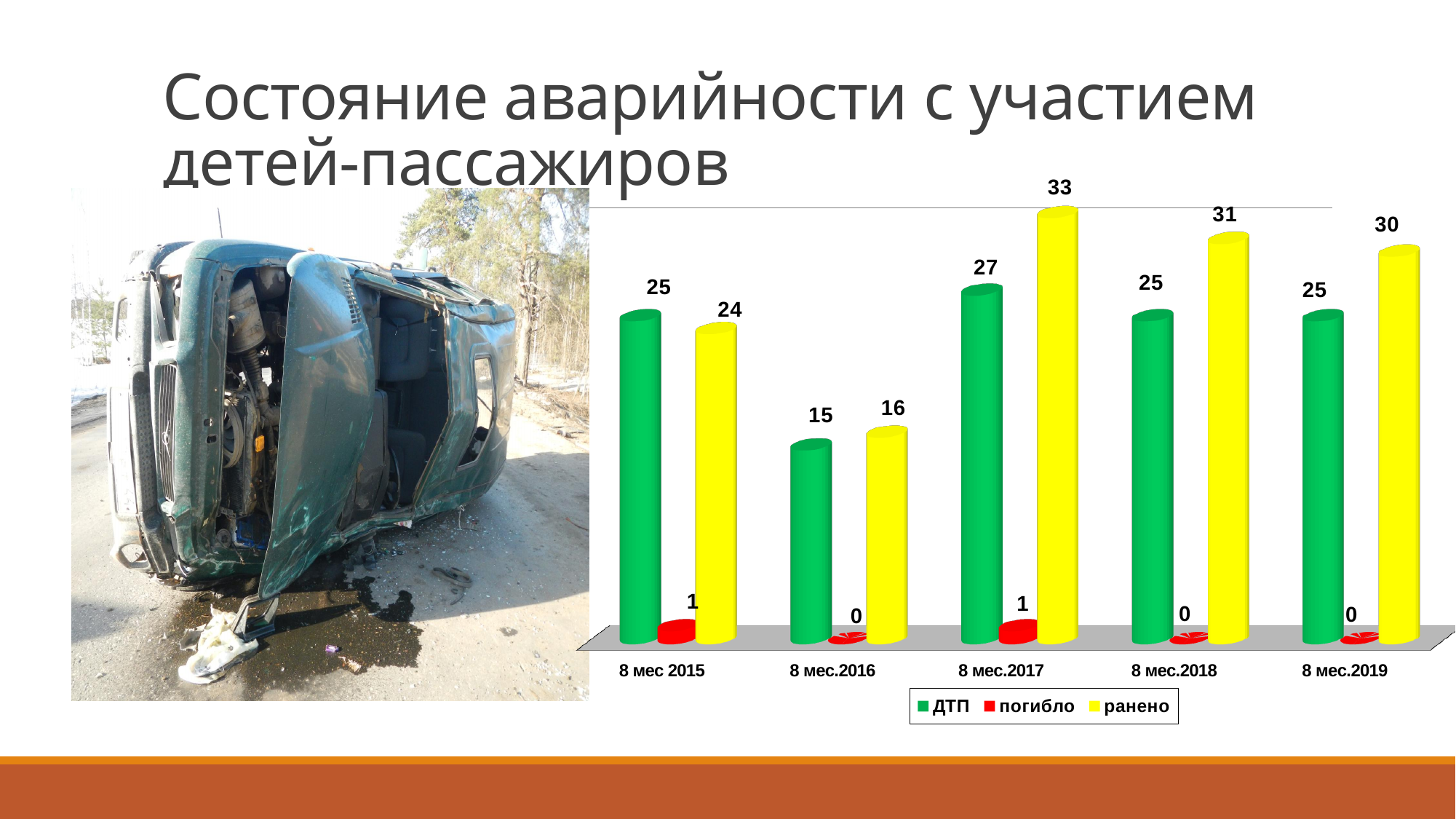
What is the value of ДТП for 8 мес.2017? 27 How many periods are shown on the x axis? 5 What is the difference between ранено for 8 мес.2017 and ранено for 8 мес.2016? 17 Which period has the lowest value of ДТП? 8 мес.2016 What is the value of погибло for 8 мес 2015? 1 How many series does the legend list? 3 What kind of chart is shown on the slide? bar chart What is the value of ранено for 8 мес.2016? 16 Which colour represents the погибло series? red Which is larger: ДТП for 8 мес.2018 or ДТП for 8 мес.2017? 8 мес.2017 Which period has the highest value of ранено? 8 мес.2017 What is the value of ранено for 8 мес.2019? 30